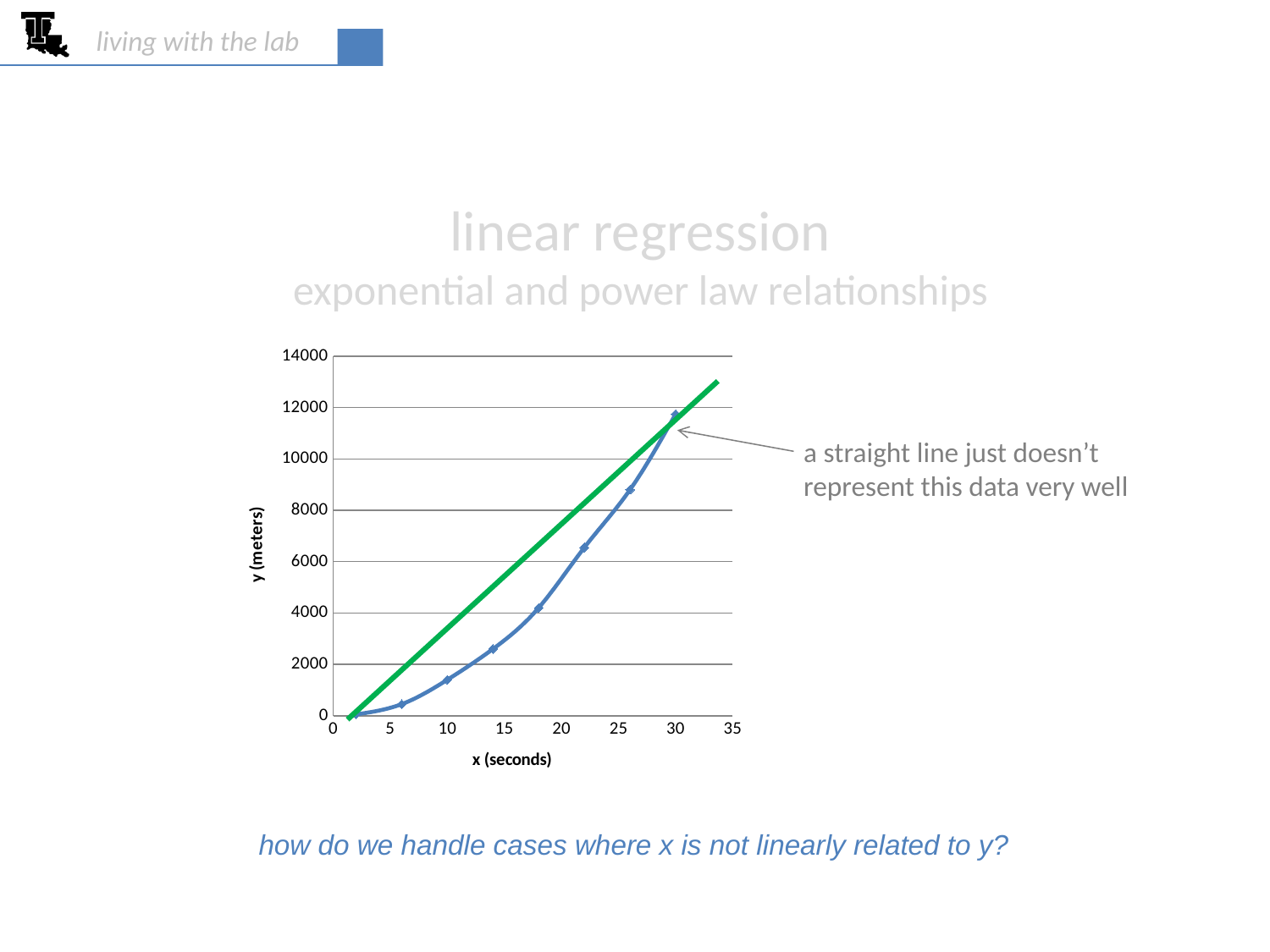
Is the y value of the data point at x = 14 greater or less than 2000? greater How many data points are plotted on the blue curve? 8 Is the y value of the data point at x = 10 greater or less than 2000? less What kind of chart is shown on the slide? line chart Do the y values rise or fall as x increases along the x axis? rise Is the y value of the data point at x = 30 greater or less than 10000? greater Which data point has the larger y value, the one at x = 26 or the one at x = 14? x = 26 What is the title of the y axis of the chart? y (meters) What is the highest value shown on the y axis of the chart? 14000 What is the title of the x axis of the chart? x (seconds) At which x value does the blue curve reach its highest y value? 30